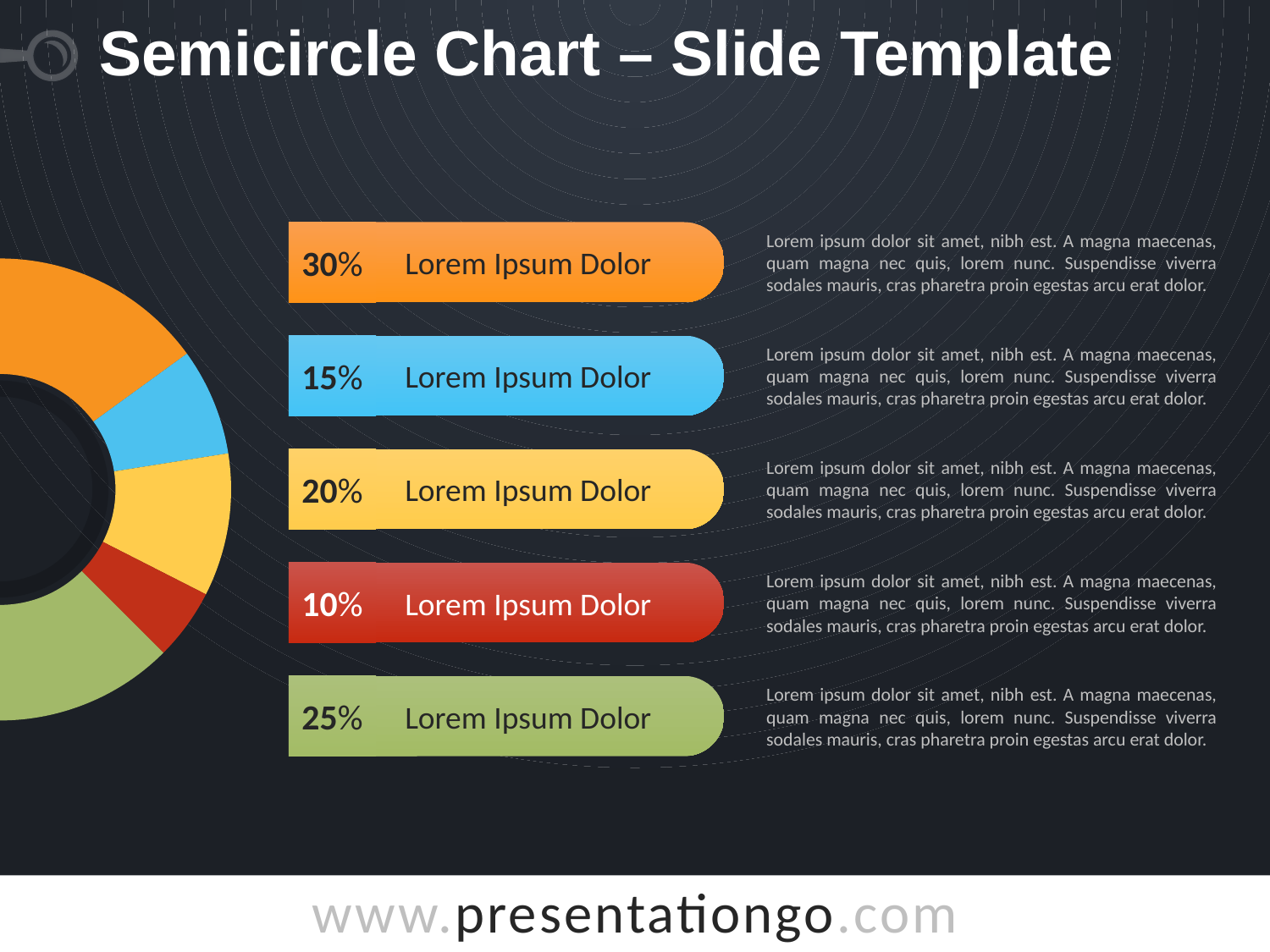
What is the title of the slide? Semicircle Chart – Slide Template Which colour segment has the highest percentage? orange (30%) What percentage is shown for the yellow segment? 20% How many segments does the semicircle chart have? 5 What kind of chart is shown on the slide? semicircle (doughnut) chart What percentage is shown for the red segment? 10% What percentage is shown for the orange segment? 30% Which is larger, the yellow segment or the blue segment? yellow What is the difference between the orange segment's percentage and the green segment's percentage? 5% What percentage is shown for the green segment? 25% Which colour segment has the lowest percentage? red (10%) What percentage is shown for the blue segment? 15%